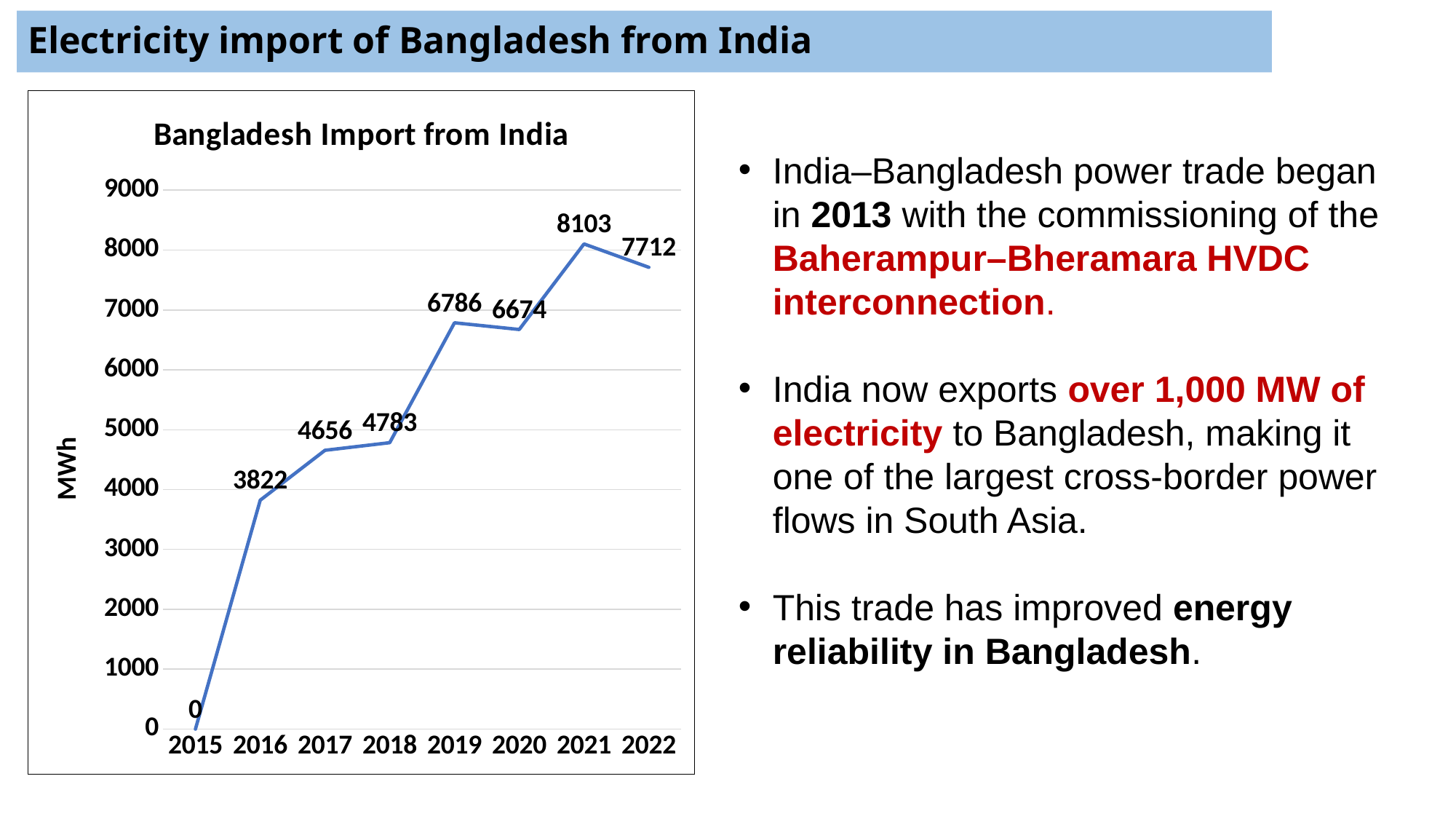
Which is larger in the Bangladesh Import from India chart, the value for 2019 or the value for 2020? 2019 What kind of chart is the Bangladesh Import from India chart? line chart Is the value for 2018 in the Bangladesh Import from India chart greater or less than 5000? less What is the difference between the values for 2021 and 2022 in the Bangladesh Import from India chart? 391 How many years are plotted in the Bangladesh Import from India chart? 8 What unit is shown on the y axis of the Bangladesh Import from India chart? MWh Which year has the lowest value in the Bangladesh Import from India chart? 2015 Which year has the highest value in the Bangladesh Import from India chart? 2021 What is the value for 2019 in the Bangladesh Import from India chart? 6786 What is the value for 2016 in the Bangladesh Import from India chart? 3822 What is the value for 2021 in the Bangladesh Import from India chart? 8103 What is the value for 2022 in the Bangladesh Import from India chart? 7712